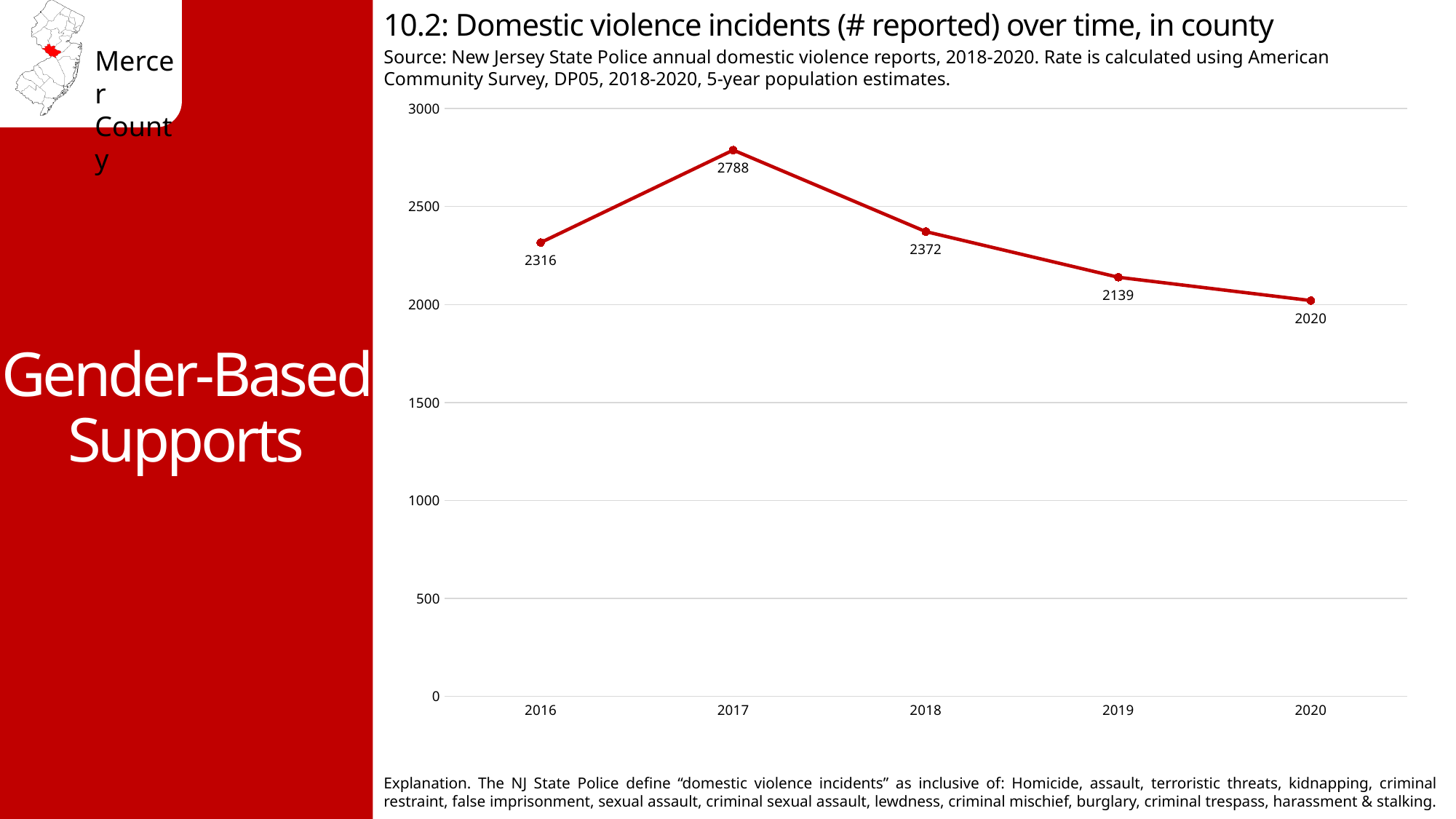
How many domestic violence incidents were reported in 2016? 2316 Is the value for 2019 greater or less than 2000? greater How many domestic violence incidents were reported in 2017? 2788 What is the difference between the number of incidents reported in 2017 and in 2018? 416 Which year had the highest number of reported domestic violence incidents? 2017 What type of chart is shown on the slide? Line chart Which year had more reported incidents, 2018 or 2019? 2018 How many domestic violence incidents were reported in 2020? 2020 From 2017 to 2020, do the reported incidents rise or fall? Fall Which year had the lowest number of reported domestic violence incidents? 2020 What is the difference between the number of incidents reported in 2016 and in 2020? 296 How many years are plotted on the chart? 5